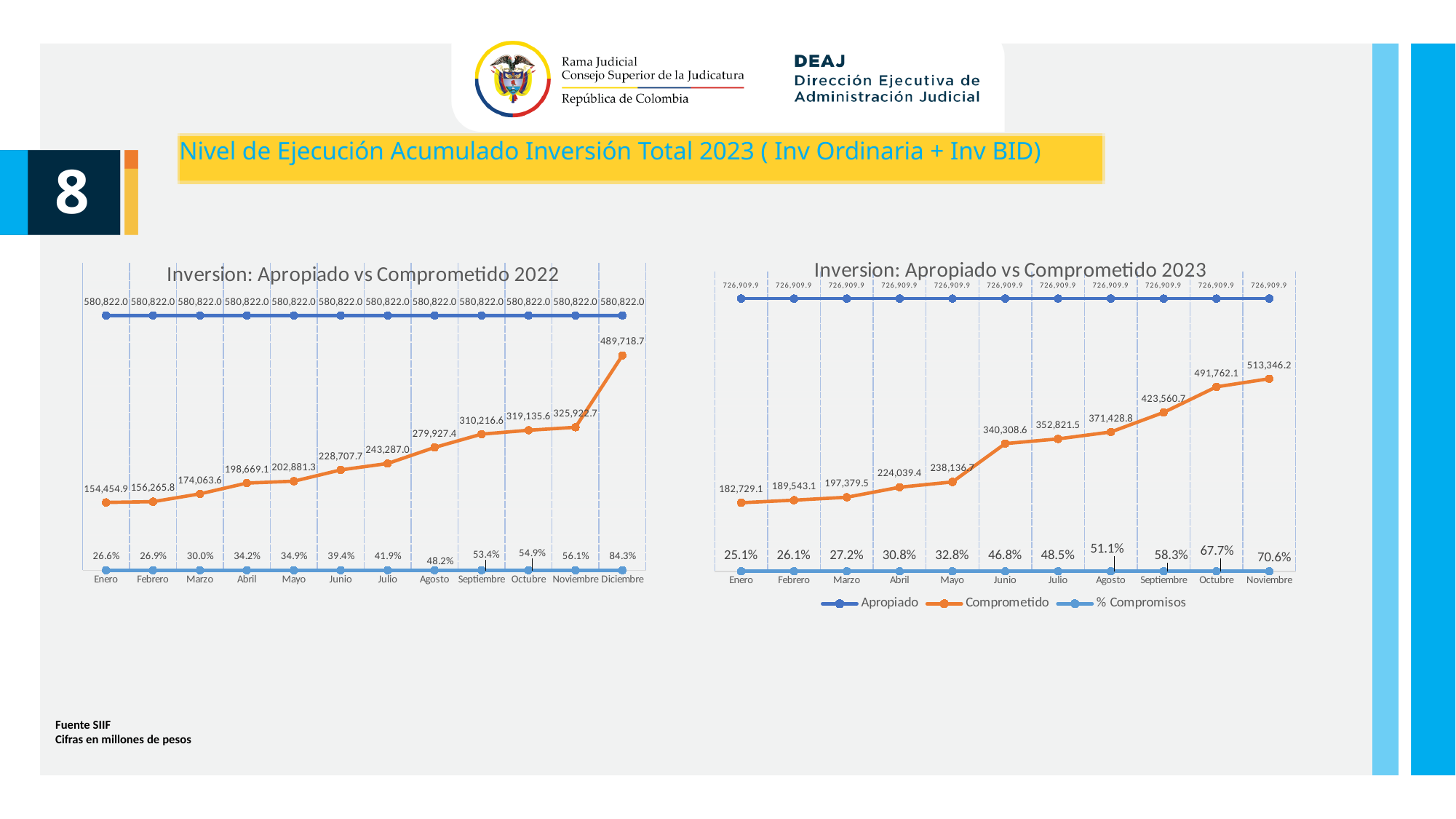
In the chart 'Inversion: Apropiado vs Comprometido 2023', which month has the highest Comprometido value? Noviembre In the chart 'Inversion: Apropiado vs Comprometido 2023', what is the % Compromisos value for Noviembre? 70.6% In the chart 'Inversion: Apropiado vs Comprometido 2023', does the Comprometido series rise or fall from Enero to Noviembre? rise In the chart 'Inversion: Apropiado vs Comprometido 2022', which month has the lowest Comprometido value? Enero In the chart 'Inversion: Apropiado vs Comprometido 2022', what is the Comprometido value for Diciembre? 489,718.7 How many months are plotted in the chart 'Inversion: Apropiado vs Comprometido 2022'? 12 What kind of chart is 'Inversion: Apropiado vs Comprometido 2022'? line chart In the chart 'Inversion: Apropiado vs Comprometido 2023', what is the Apropiado value shown for each month? 726,909.9 How many series does the legend of the chart 'Inversion: Apropiado vs Comprometido 2023' list? 3 In the chart 'Inversion: Apropiado vs Comprometido 2022', what is the difference between the Comprometido values for Diciembre and Noviembre? 163,796.0 In the chart 'Inversion: Apropiado vs Comprometido 2023', is the Comprometido value for Junio larger or smaller than the Comprometido value for Mayo? larger How many months are plotted in the chart 'Inversion: Apropiado vs Comprometido 2023'? 11